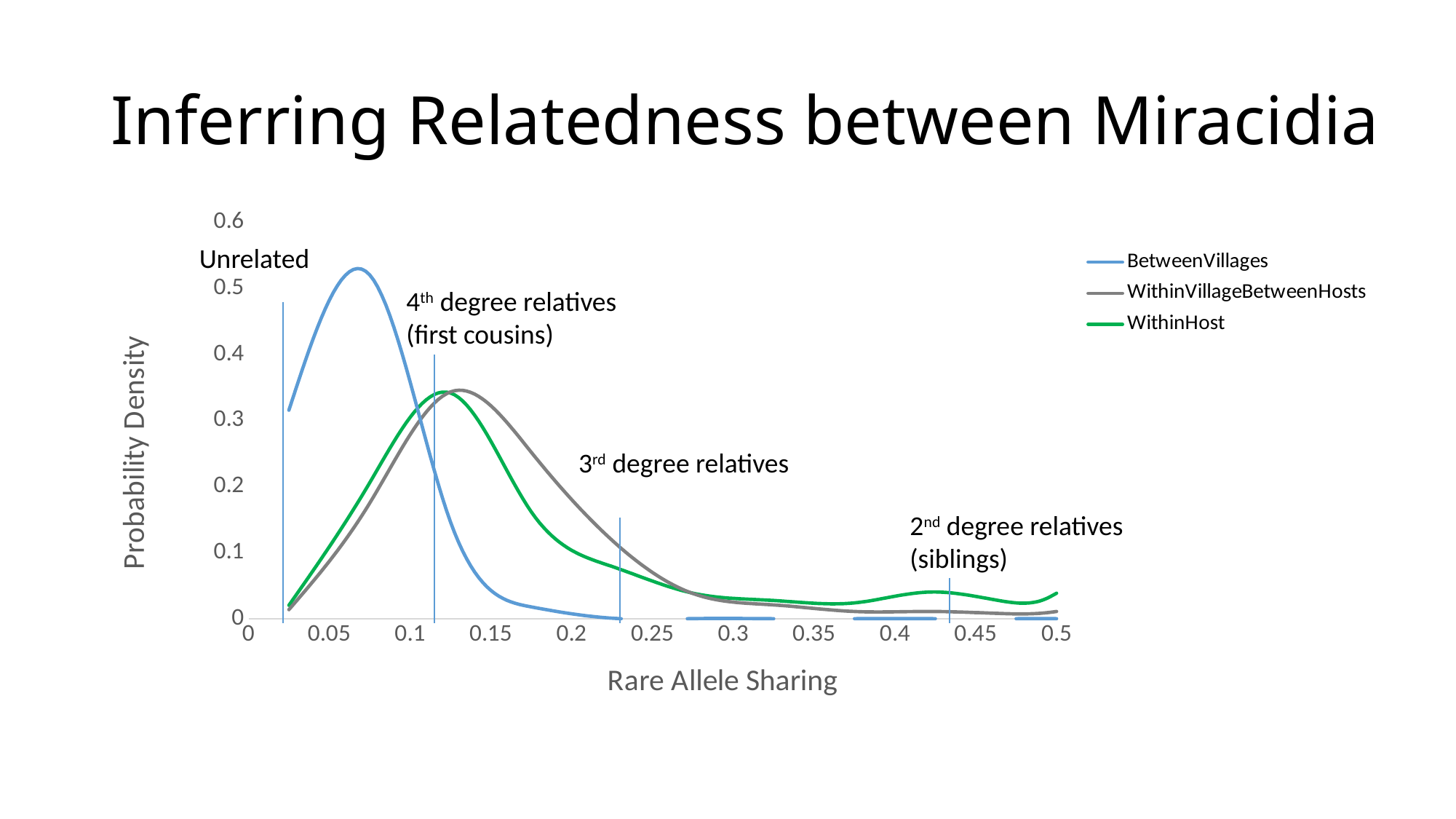
What is the title of the x axis? Rare Allele Sharing Is the peak value of the BetweenVillages series greater or less than 0.4? greater What kind of chart is shown on the slide? Line chart Is the value of the BetweenVillages series at Rare Allele Sharing 0.3 greater or less than 0.1? less What is the title of the y axis? Probability Density Which series reaches the highest peak probability density? BetweenVillages Is the peak value of the WithinHost series greater or less than 0.4? less Which series peaks at the lowest Rare Allele Sharing value? BetweenVillages How many series does the legend list? 3 Which series has a higher peak, WithinHost or BetweenVillages? BetweenVillages Does the BetweenVillages series rise or fall as Rare Allele Sharing increases from 0.1 to 0.2? Fall